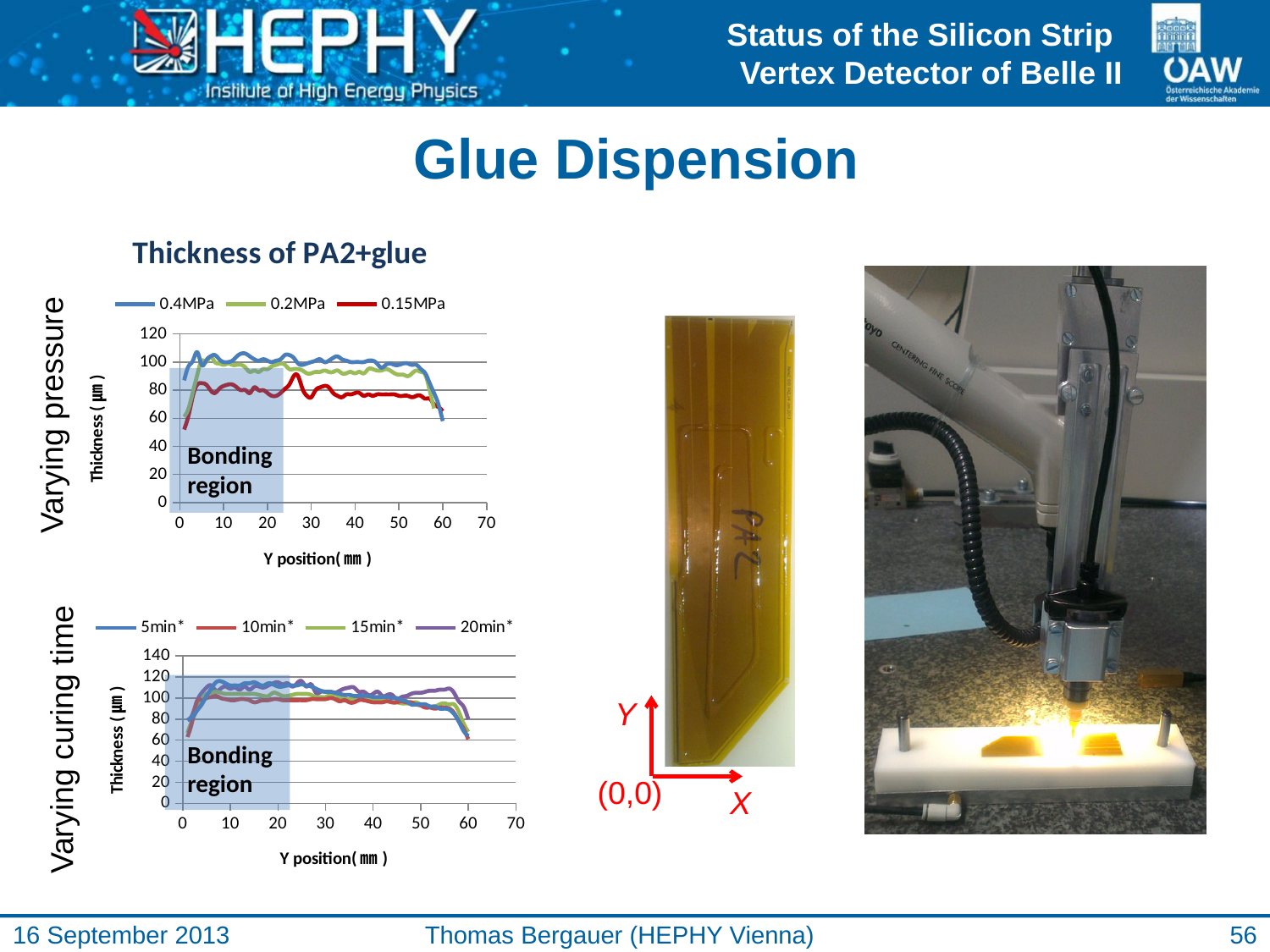
In the bottom chart (varying curing time), at Y position 10 mm, which series has the larger thickness: 5min* or 10min*? 5min* What is the x-axis label of the bottom chart (varying curing time)? Y position( mm ) In the top chart (varying pressure), which series has the lowest thickness across most of the Y range? 0.15MPa What is the highest tick value shown on the y-axis of the bottom chart (varying curing time)? 140 In the bottom chart (varying curing time), is the thickness for the 20min* series at Y position 50 mm greater or less than 80? greater How many series does the legend of the bottom chart (varying curing time) list? 4 In the top chart (varying pressure), which series is plotted in red? 0.15MPa In the top chart (varying pressure), is the thickness for the 0.4MPa series at Y position 10 mm greater or less than 80? greater In the top chart (varying pressure), is the thickness for the 0.15MPa series at Y position 40 mm greater or less than 100? less In the top chart (varying pressure), at Y position 40 mm, which series has the larger thickness: 0.4MPa or 0.15MPa? 0.4MPa How many series does the legend of the top chart (varying pressure) list? 3 What kind of chart is the top chart titled 'Thickness of PA2+glue'? line chart